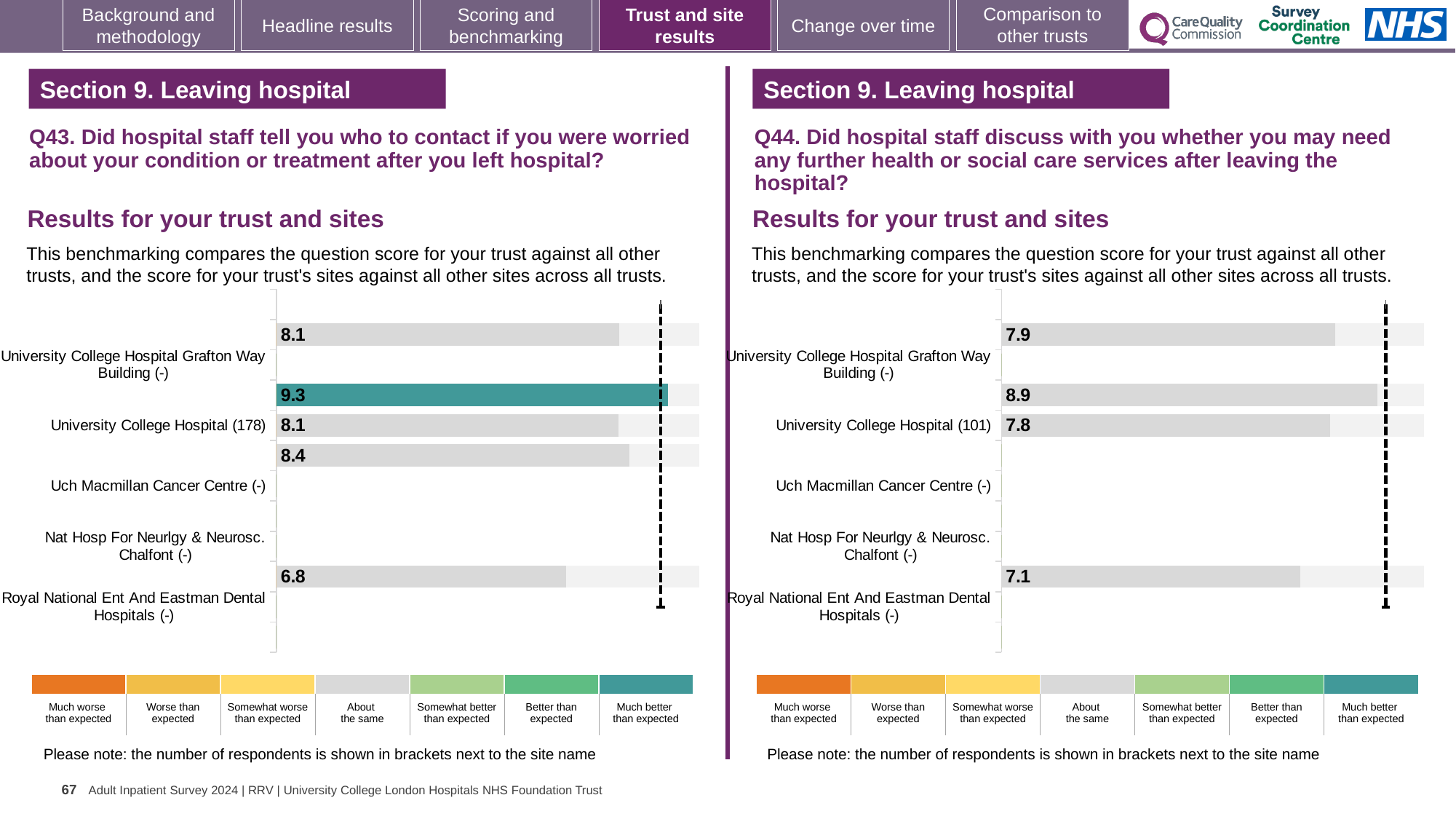
How many bars with data labels are shown on the left (Q43) chart? 5 On the right (Q44) chart, what is the difference between the highest bar value (8.9) and the lowest bar value (7.1)? 1.8 How many categories does the colour legend below each chart list? 7 On the left (Q43) chart, what is the highest score shown on any bar? 9.3 On the left (Q43) chart, what is the difference between the highest bar value (9.3) and the lowest bar value (6.8)? 2.5 On the left (Q43) chart, what is the lowest score shown on any bar? 6.8 On the left (Q43) chart, which legend category does the teal colour of the 9.3 bar correspond to? Much better than expected How many bars with data labels are shown on the right (Q44) chart? 4 On the right (Q44) chart, what is the highest score shown on any bar? 8.9 On the right (Q44) chart, what is the lowest score shown on any bar? 7.1 Which chart has the higher maximum bar value, the left (Q43) chart or the right (Q44) chart? the left (Q43) chart What type of chart is used on the left (Q43) chart? bar chart